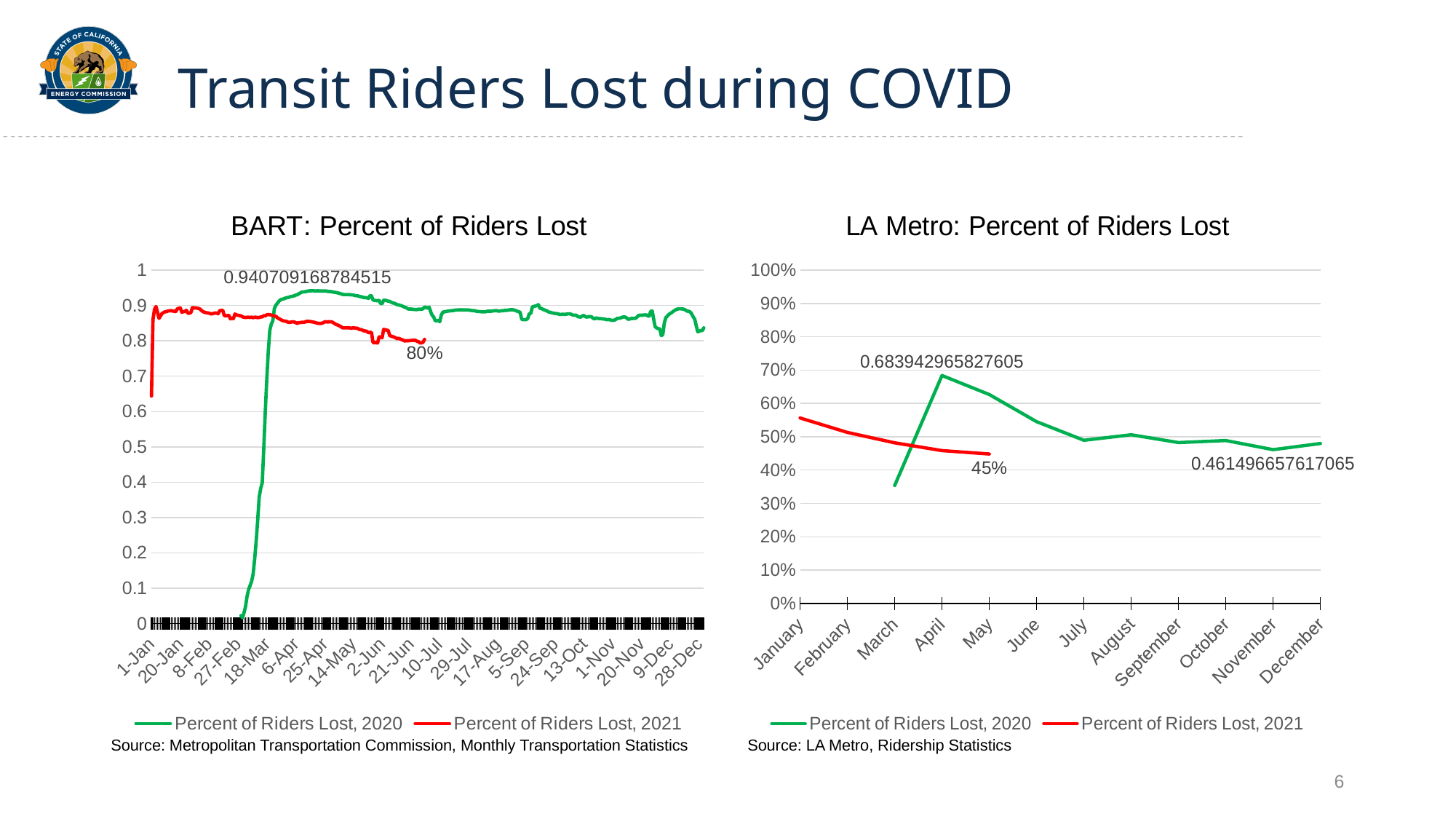
How many series does the legend of the LA Metro: Percent of Riders Lost chart list? 2 In the LA Metro: Percent of Riders Lost chart, what is the value labelled for May on the Percent of Riders Lost, 2021 line? 45% In the LA Metro: Percent of Riders Lost chart, which month has the highest value on the Percent of Riders Lost, 2020 line? April What kind of chart is the BART: Percent of Riders Lost chart? line chart In the BART: Percent of Riders Lost chart, what is the peak value labelled on the Percent of Riders Lost, 2020 line? 0.940709168784515 In the LA Metro: Percent of Riders Lost chart, what is the value labelled for April on the Percent of Riders Lost, 2020 line? 0.683942965827605 In the LA Metro: Percent of Riders Lost chart, does the Percent of Riders Lost, 2021 line rise or fall from January to May? fall In the LA Metro: Percent of Riders Lost chart, is the January value of the Percent of Riders Lost, 2021 line greater or less than 50%? greater In the LA Metro: Percent of Riders Lost chart, is the March value of the Percent of Riders Lost, 2020 line greater or less than 40%? less How many months are shown on the x axis of the LA Metro: Percent of Riders Lost chart? 12 In the BART: Percent of Riders Lost chart, what value is labelled at the end of the Percent of Riders Lost, 2021 line? 80%